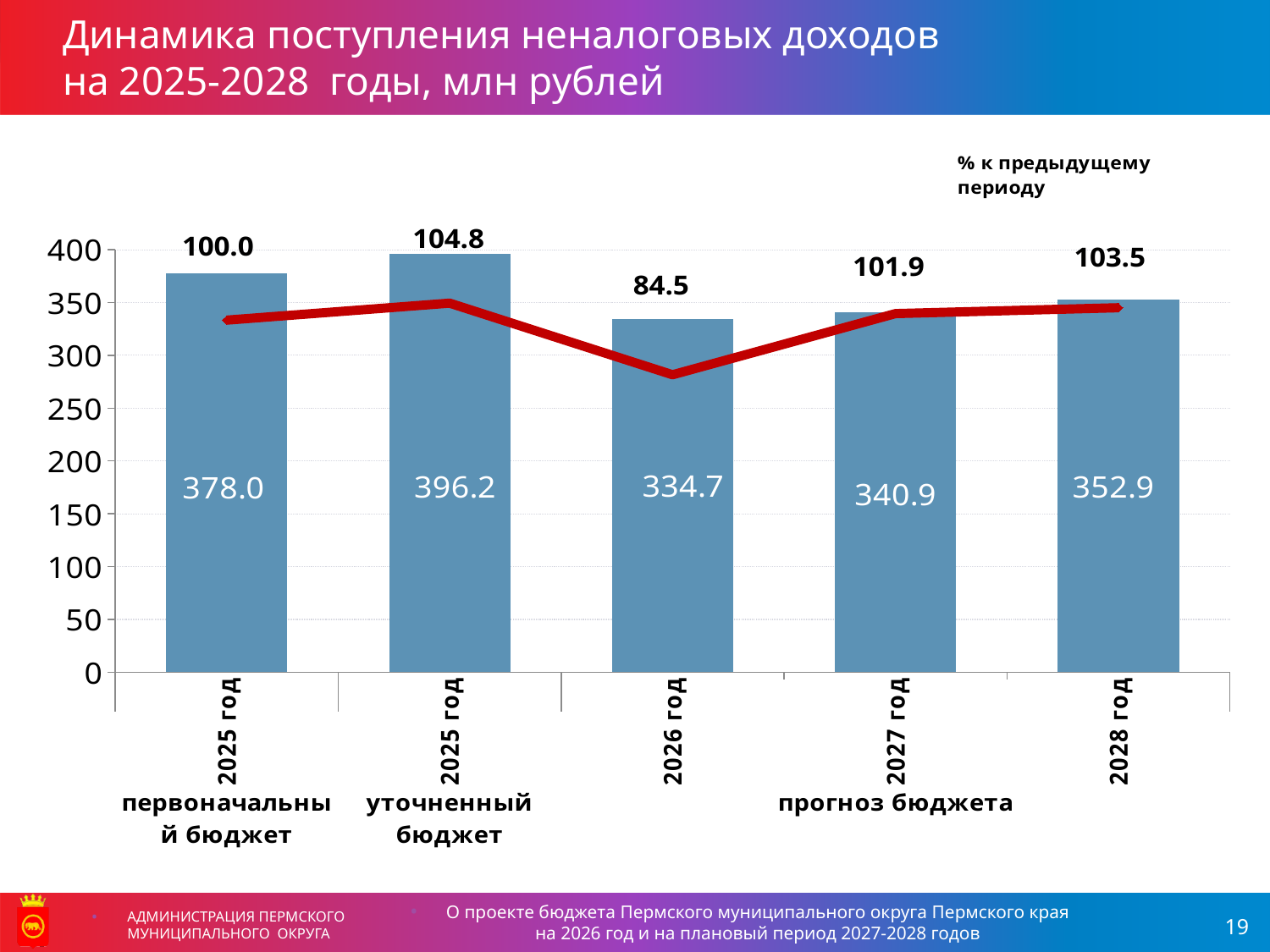
What is the difference between the bar values for 2025 год (уточненный бюджет) and 2026 год? 61.5 What is the title of the chart? Динамика поступления неналоговых доходов на 2025-2028 годы, млн рублей What is the value of the bar for 2026 год? 334.7 What is the value of the bar for 2028 год? 352.9 What is the '% к предыдущему периоду' value shown for 2026 год? 84.5 How many bars are plotted on the chart? 5 Which category has the lowest bar value? 2026 год What is the value of the bar for 2025 год (уточненный бюджет)? 396.2 Do the bar values rise or fall from 2026 год to 2028 год? rise What is the '% к предыдущему периоду' value shown for 2027 год? 101.9 Which bar is larger: 2027 год or 2028 год? 2028 год Which category has the highest bar value? 2025 год (уточненный бюджет)